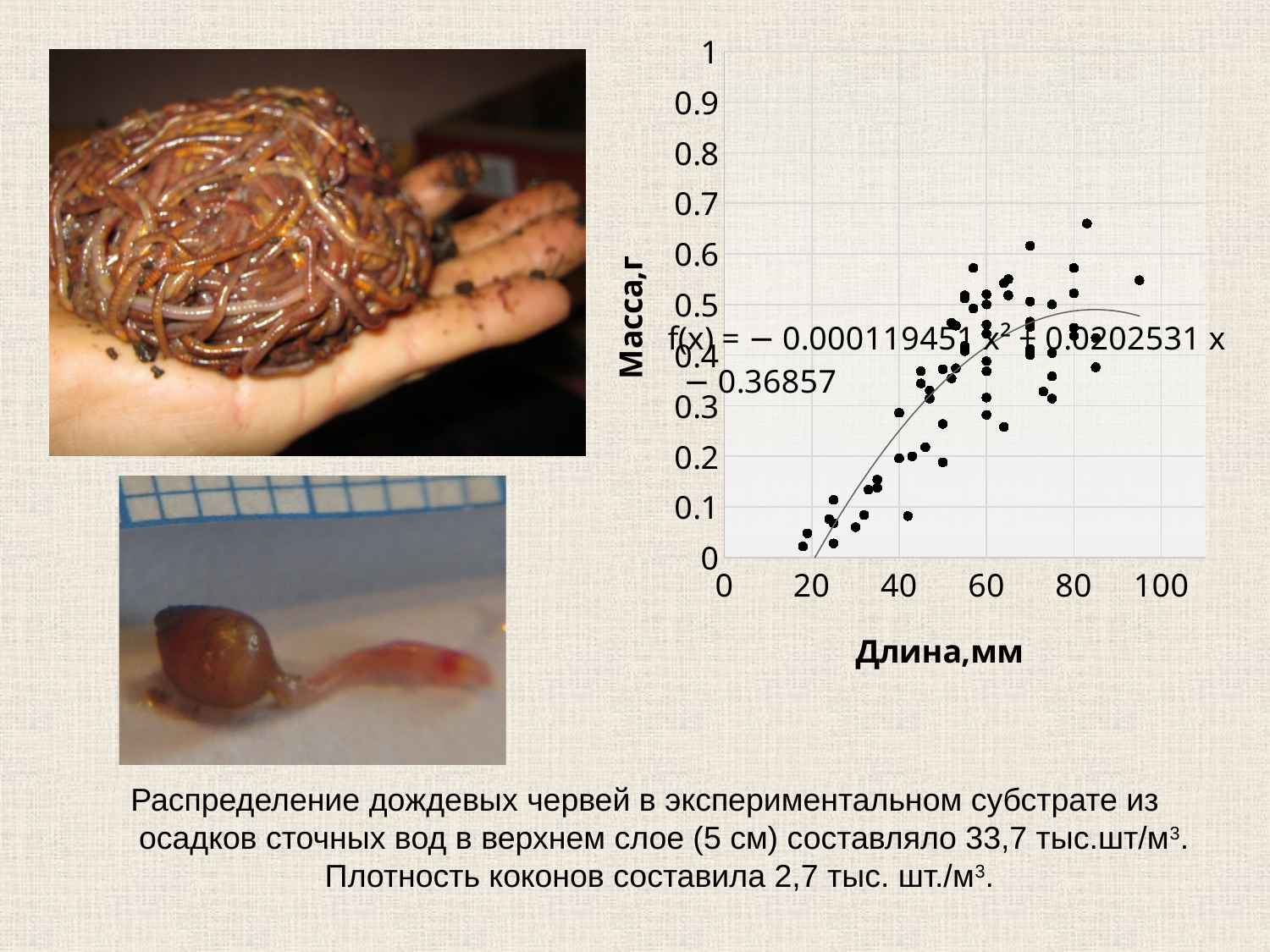
What is the coefficient of x² in the trendline equation shown on the chart? −0.000119451 Is the mass of the point with the largest length (near 95 mm) greater or less than 0.5? greater What is the maximum tick value shown on the horizontal axis? 100 Overall, does the mass rise or fall as length increases along the x axis? rise What is the constant term in the trendline equation shown on the chart? −0.36857 What is the title of the horizontal axis of the chart? Длина,мм What kind of chart is shown on the slide? scatter chart What is the title of the vertical axis of the chart? Масса,г What is the coefficient of x in the trendline equation shown on the chart? 0.0202531 Is the lowest plotted mass value greater or less than 0.1? less Is the highest plotted mass value greater or less than 0.6? greater What is the maximum value shown on the vertical axis? 1